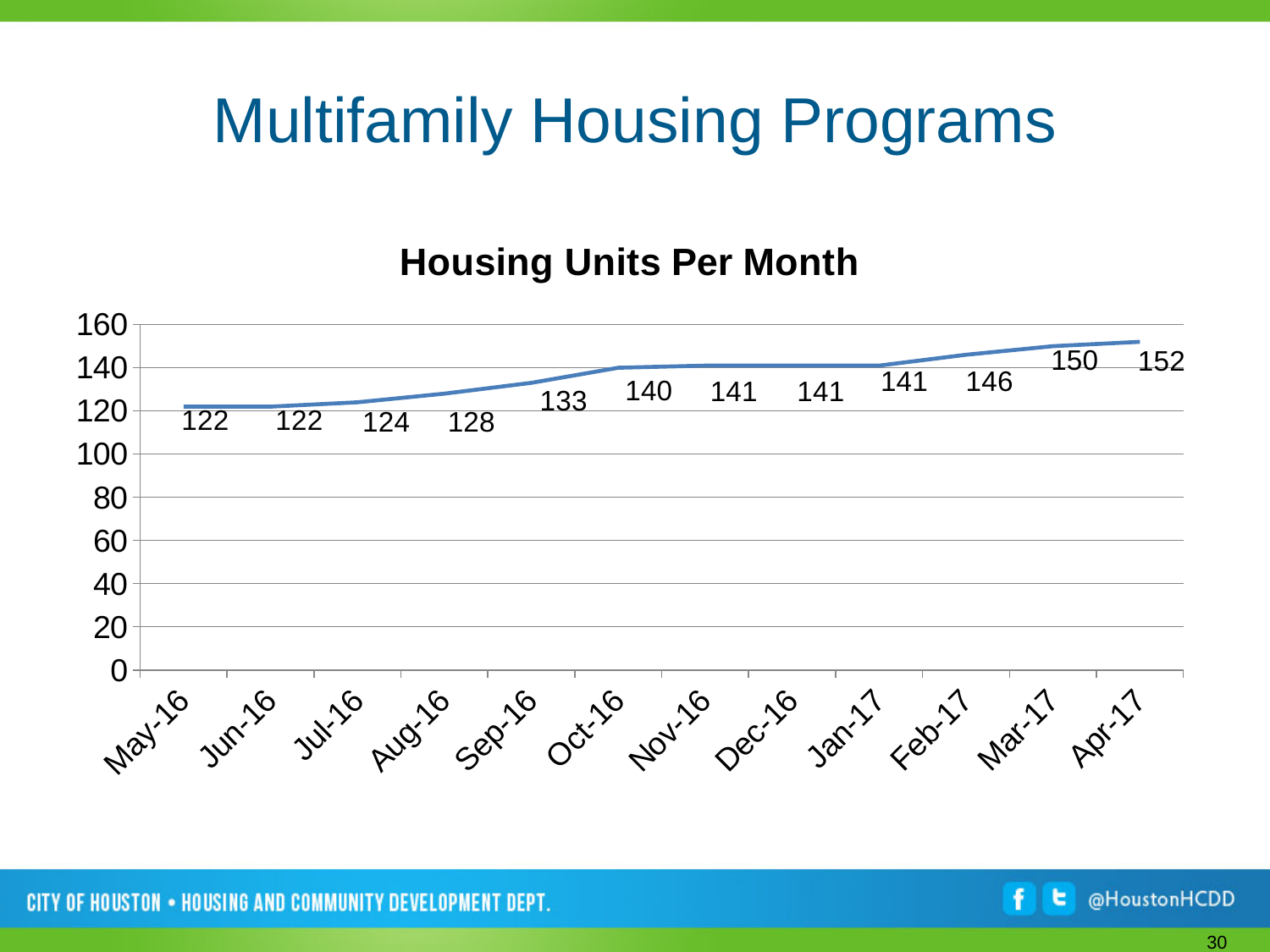
What is the title of the chart? Housing Units Per Month What kind of chart is shown? line chart How many months are plotted on the chart? 12 What is the value for Feb-17? 146 Is the value for Aug-16 greater or less than 140? less What is the value for Sep-16? 133 What is the value for Apr-17? 152 What is the difference between the values for Oct-16 and Sep-16? 7 Which month has the highest value? Apr-17 What is the difference between the values for Apr-17 and May-16? 30 Do the values rise or fall from May-16 to Apr-17? rise Which is larger, the value for Mar-17 or the value for Jan-17? Mar-17